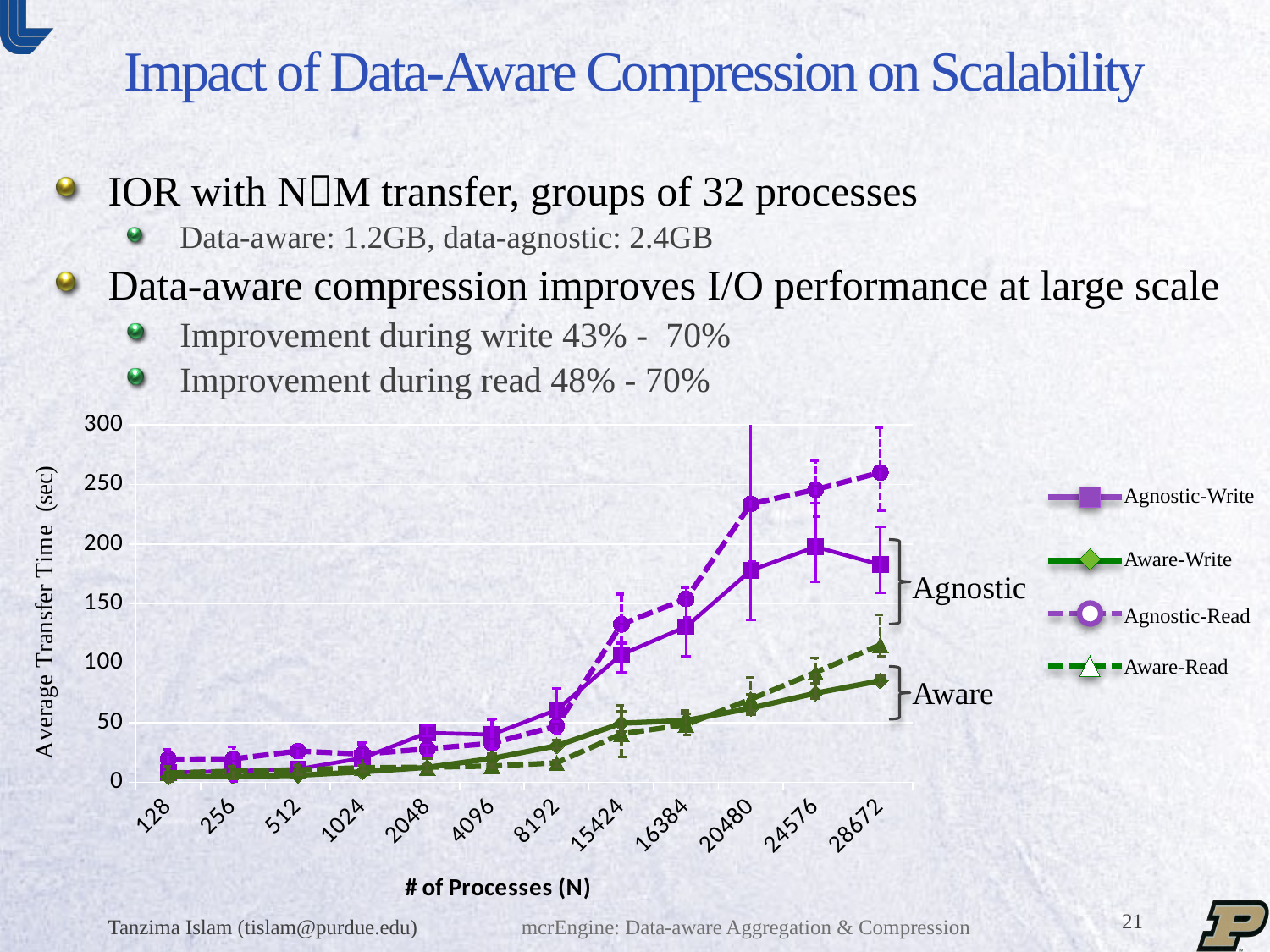
Is the Aware-Write value at 28672 processes greater or less than 100? less How many series does the chart legend list? 4 Is the Aware-Write value at 8192 processes greater or less than 50? less What is the title of the x axis of the chart? # of Processes (N) Is the Agnostic-Write value at 24576 processes greater or less than 150? greater What kind of chart is shown on the slide? line chart How many values of # of Processes (N) are shown on the x axis? 12 Which series has the highest Average Transfer Time at 28672 processes? Agnostic-Read At 28672 processes, which is larger: Agnostic-Read or Aware-Read? Agnostic-Read Which series has the lowest Average Transfer Time at 28672 processes? Aware-Write Does the Agnostic-Read series generally rise or fall as the number of processes increases? rise